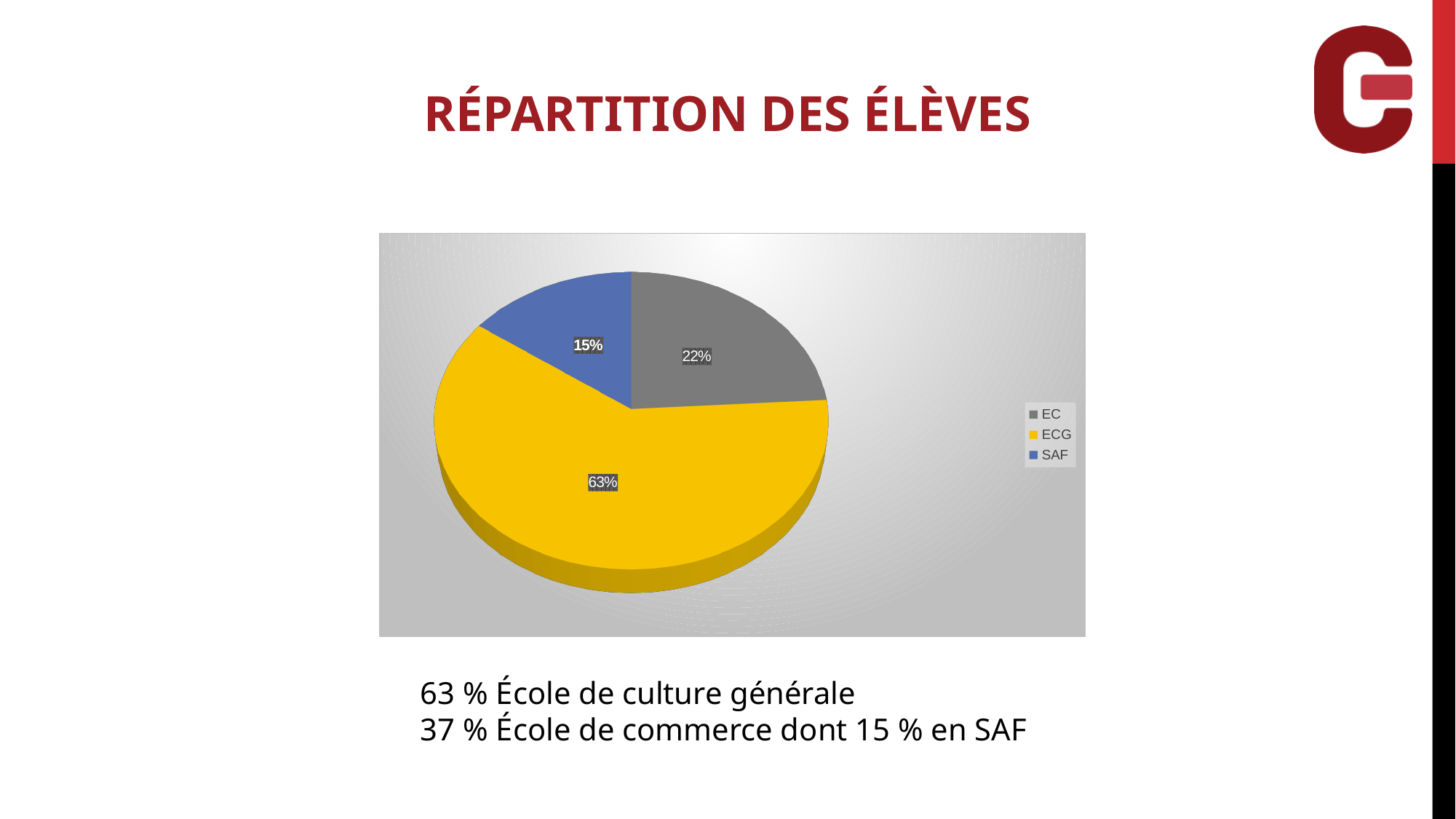
How many slices does the pie chart have? 3 What share of the pie does EC represent? 22% What share of the pie does ECG represent? 63% What is the difference in percentage points between the EC slice and the SAF slice? 7 Which category has the largest slice of the pie? ECG What share of the pie does SAF represent? 15% Which category has the smallest slice of the pie? SAF What is the difference in percentage points between the ECG slice and the EC slice? 41 What colour is the ECG slice? Yellow What kind of chart is shown on the slide? Pie chart How many entries does the legend list? 3 Which slice is larger, EC or SAF? EC